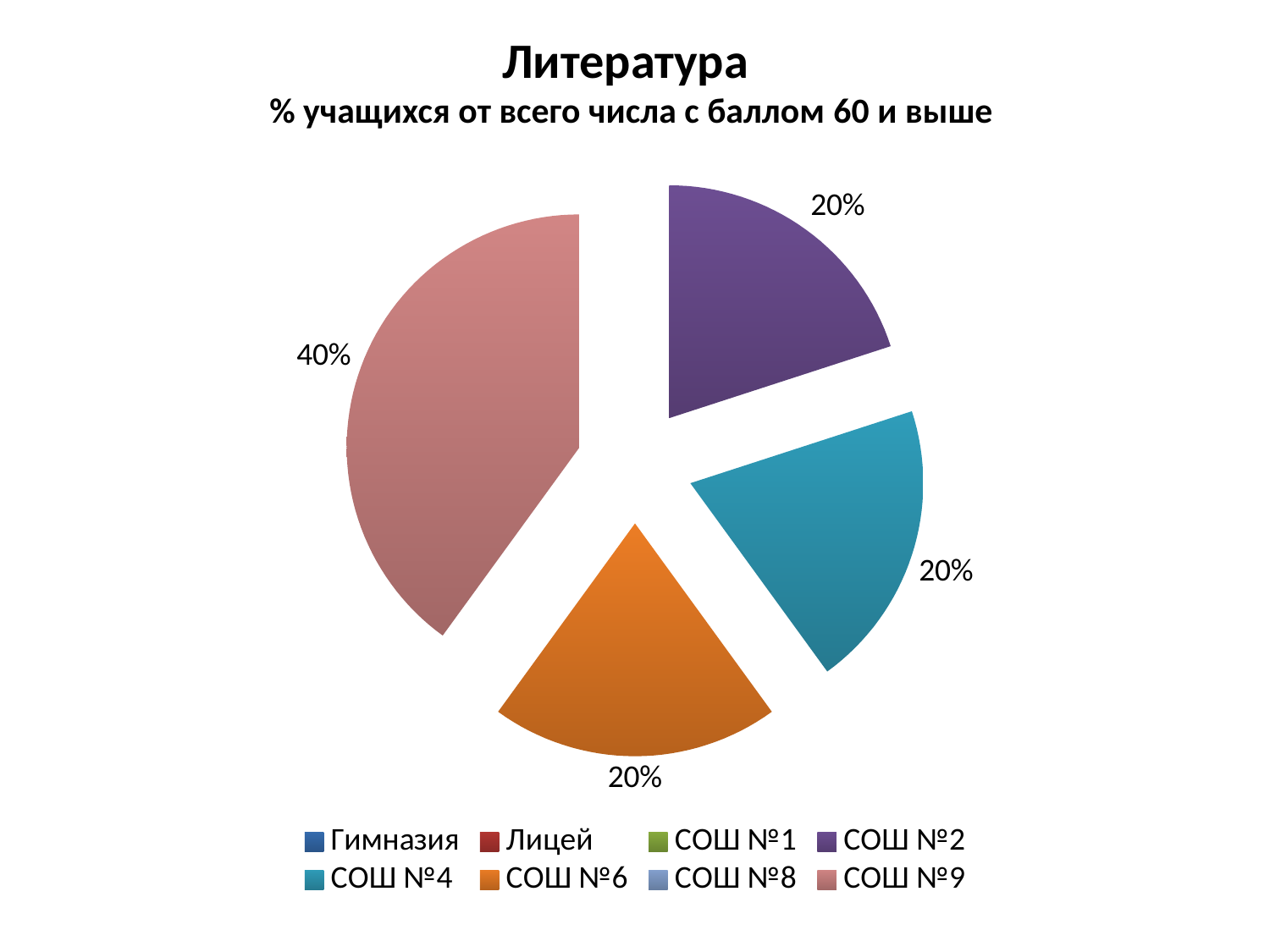
What colour is the slice for СОШ №6? orange What percentage is shown for СОШ №6? 20% Which is larger, the slice for СОШ №9 or the slice for СОШ №6? СОШ №9 What is the difference between the percentage for СОШ №9 and the percentage for СОШ №2? 20% What is the title of the chart? Литература How many slices with data labels are visible in the pie? 4 What percentage is shown for СОШ №9? 40% What percentage is shown for СОШ №4? 20% What kind of chart is shown on the slide? pie chart Which school has the largest slice of the pie? СОШ №9 What percentage is shown for СОШ №2? 20% How many entries does the legend list? 8